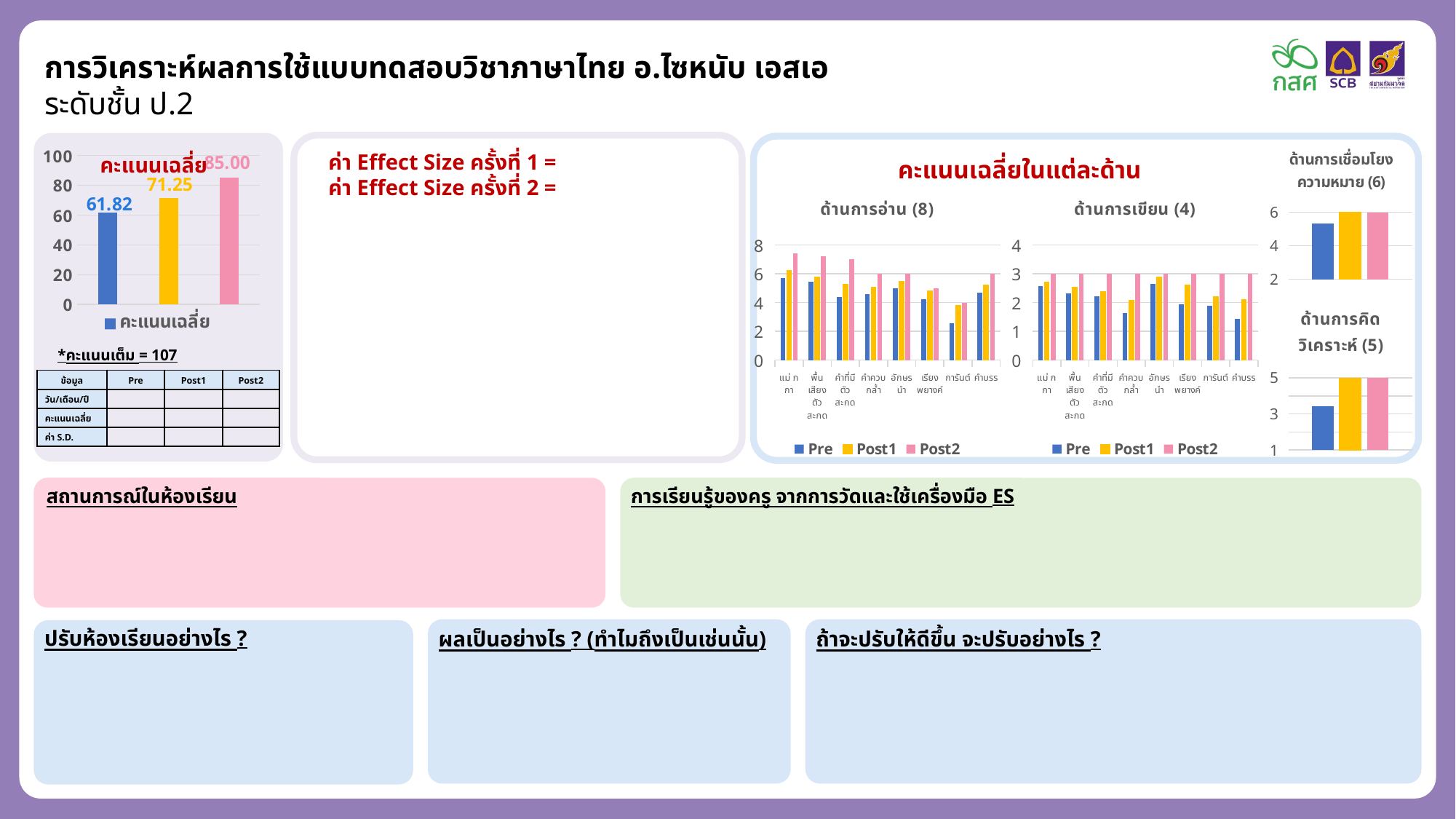
In the "ด้านการอ่าน (8)" chart, how many series does the legend list? 3 In the "คะแนนเฉลี่ย" chart on the left, which bar is the highest? The third (pink) bar, 85.00 In the "ด้านการเขียน (4)" chart, how many categories are shown on the x axis? 8 In the "คะแนนเฉลี่ย" chart on the left, what is the value of the first (blue) bar? 61.82 In the "คะแนนเฉลี่ย" chart on the left, how many bars are plotted? 3 In the "คะแนนเฉลี่ย" chart on the left, what is the value of the middle (yellow) bar? 71.25 In the "คะแนนเฉลี่ย" chart on the left, what is the difference between the pink bar and the blue bar? 23.18 In the "ด้านการคิดวิเคราะห์ (5)" chart, which is larger, the Pre bar or the Post1 bar? Post1 In the "ด้านการอ่าน (8)" chart, is the Post2 value for the first category (แม่ กก) greater or less than 6? greater What type of chart is the "คะแนนเฉลี่ย" chart on the left? Bar chart In the "คะแนนเฉลี่ย" chart on the left, what is the value of the third (pink) bar? 85.00 In the "ด้านการเขียน (4)" chart, is the Pre value for the last category (คำบรร) greater or less than 2? less